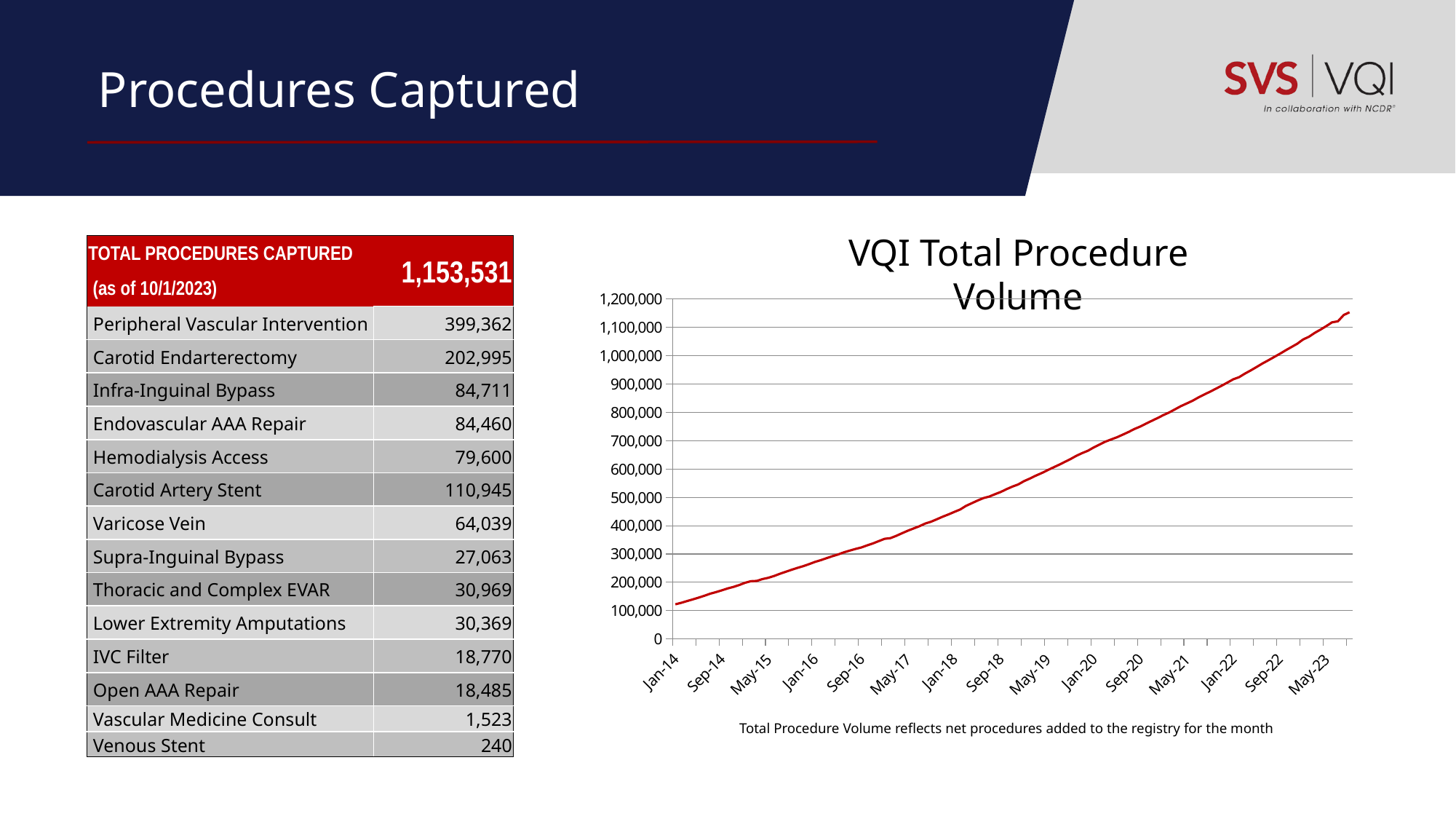
In the VQI Total Procedure Volume chart, is the value at Jan-14 greater or less than 200,000? less In the VQI Total Procedure Volume chart, which x-axis label has the lowest value? Jan-14 How many x-axis tick labels are shown on the VQI Total Procedure Volume chart? 15 What is the title of the chart on the right of the slide? VQI Total Procedure Volume In the VQI Total Procedure Volume chart, which is larger, the value at Jan-16 or the value at Jan-20? Jan-20 In the VQI Total Procedure Volume chart, is the value at May-21 greater or less than 900,000? less In the VQI Total Procedure Volume chart, is the value at Jan-18 greater or less than 400,000? greater What kind of chart is the VQI Total Procedure Volume chart? line chart In the VQI Total Procedure Volume chart, which x-axis label has the highest value? May-23 Do the values in the VQI Total Procedure Volume chart rise or fall from Jan-14 to May-23? rise